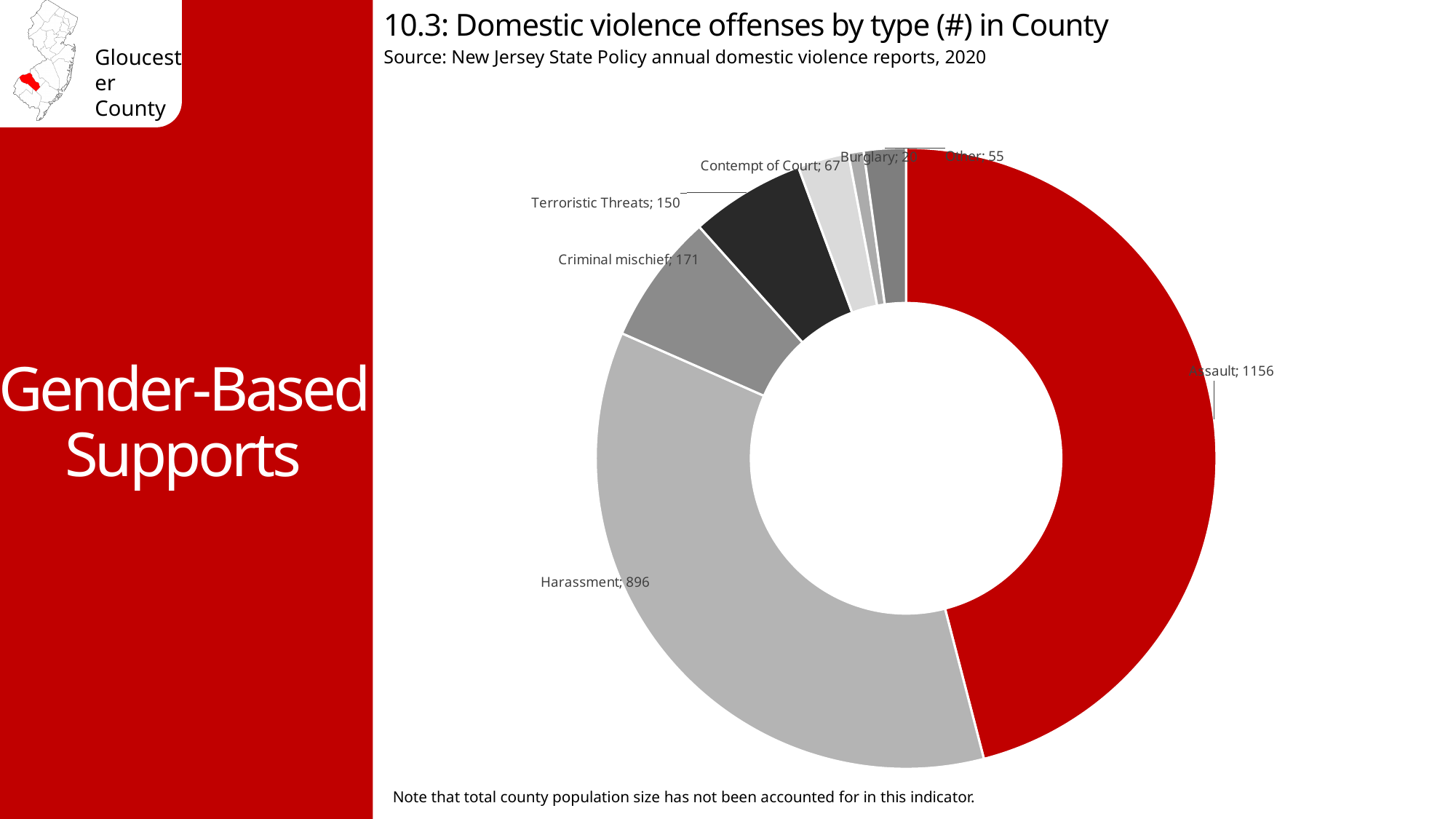
What is the value for Assault in the chart? 1156 What is the value for Harassment in the chart? 896 What is the difference between the values for Criminal mischief and Terroristic Threats? 21 What is the value for Contempt of Court in the chart? 67 How many offense types are shown in the chart? 7 What is the value for Other in the chart? 55 What kind of chart is shown on the slide? doughnut chart What is the value for Terroristic Threats in the chart? 150 Which offense type has the highest value in the chart? Assault Which is larger, the value for Contempt of Court or the value for Other? Contempt of Court What is the value for Criminal mischief in the chart? 171 What is the difference between the values for Assault and Harassment? 260